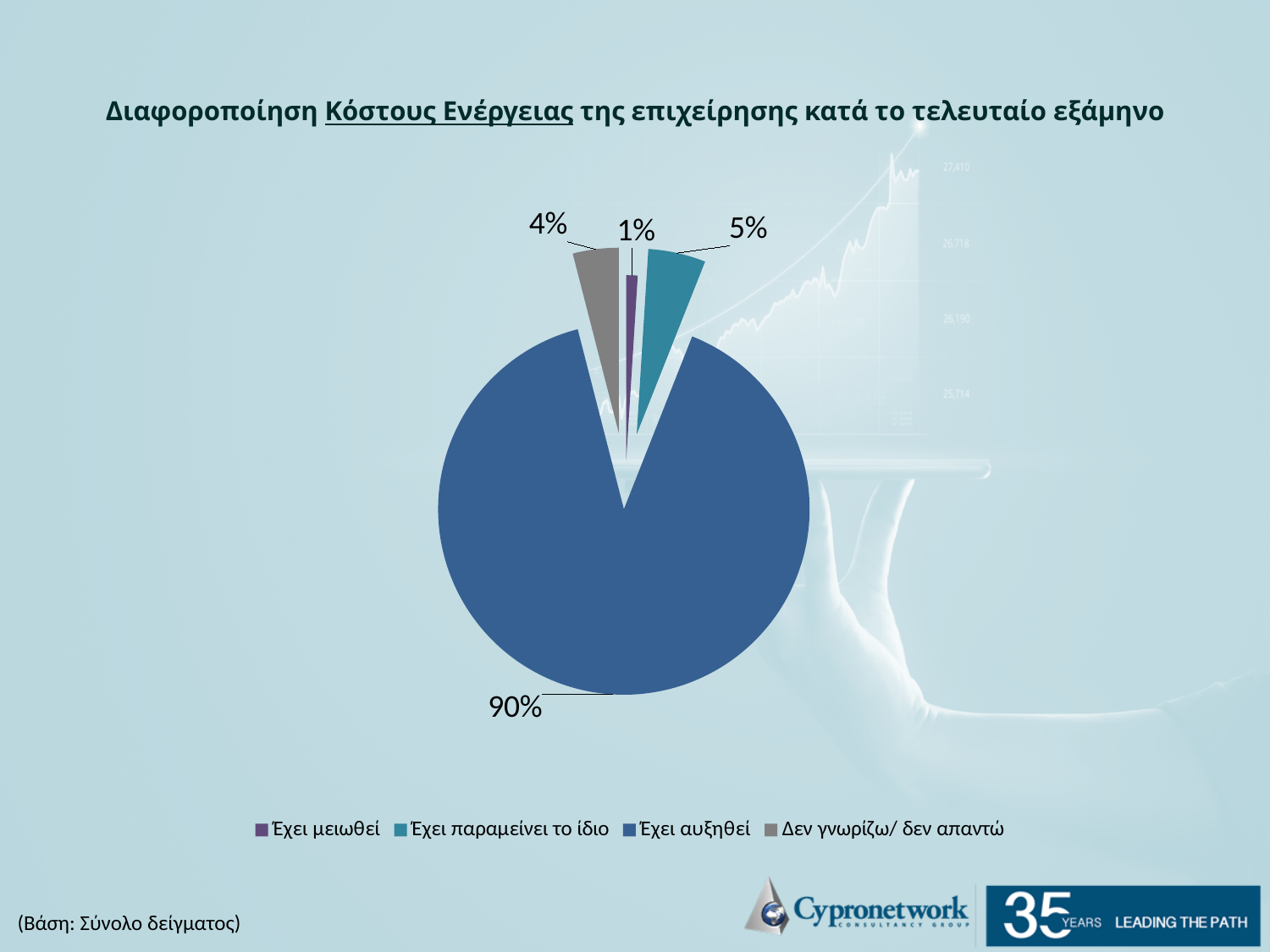
Which category has the smallest slice of the pie? Έχει μειωθεί Which category has the largest slice of the pie? Έχει αυξηθεί Which is larger, the value for "Έχει παραμείνει το ίδιο" or the value for "Έχει μειωθεί"? Έχει παραμείνει το ίδιο How many entries does the legend list? 4 What kind of chart is shown on the slide? Pie chart What is the value shown for "Έχει μειωθεί"? 1% What is the difference between the values for "Έχει παραμείνει το ίδιο" and "Δεν γνωρίζω/ δεν απαντώ"? 1% What share of the pie does "Έχει αυξηθεί" hold? 90% What is the value shown for "Έχει παραμείνει το ίδιο"? 5% What colour is the slice for "Δεν γνωρίζω/ δεν απαντώ"? Grey How many slices does the pie chart have? 4 What is the value shown for "Δεν γνωρίζω/ δεν απαντώ"? 4%